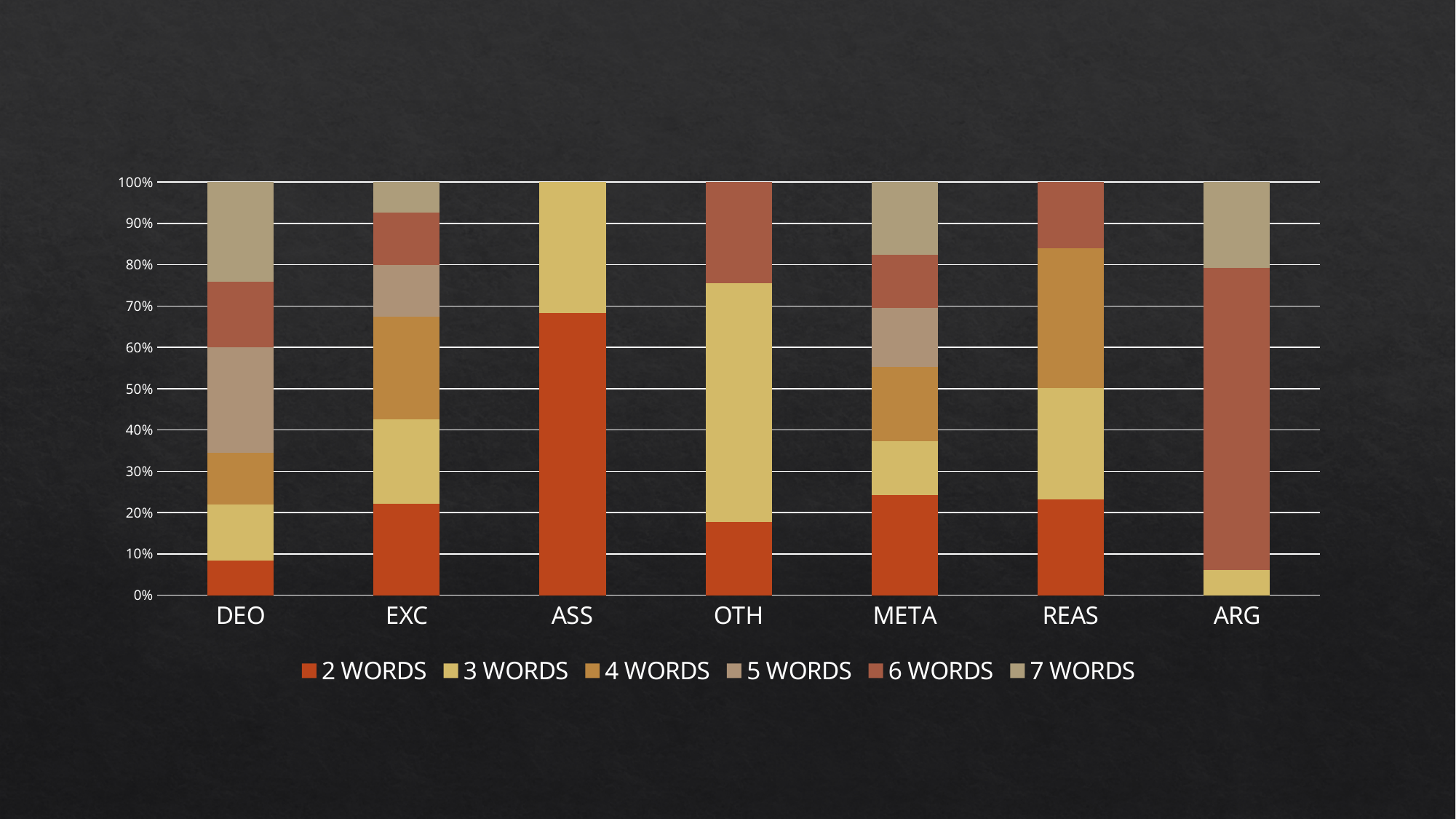
Is the 2 WORDS share for ASS greater or less than 60%? greater Which category has the largest 2 WORDS share? ASS Which legend entry is shown in the darkest orange-red colour at the bottom of the bars? 2 WORDS Is the 2 WORDS share for DEO greater or less than 10%? less Is the 3 WORDS share for OTH greater or less than 50%? greater Which has the larger 2 WORDS share, ASS or OTH? ASS How many categories are shown on the x axis? 7 Which category has the largest 6 WORDS share? ARG What does each stacked bar total on the y axis? 100% How many series does the legend list? 6 What kind of chart is shown on the slide? stacked bar chart